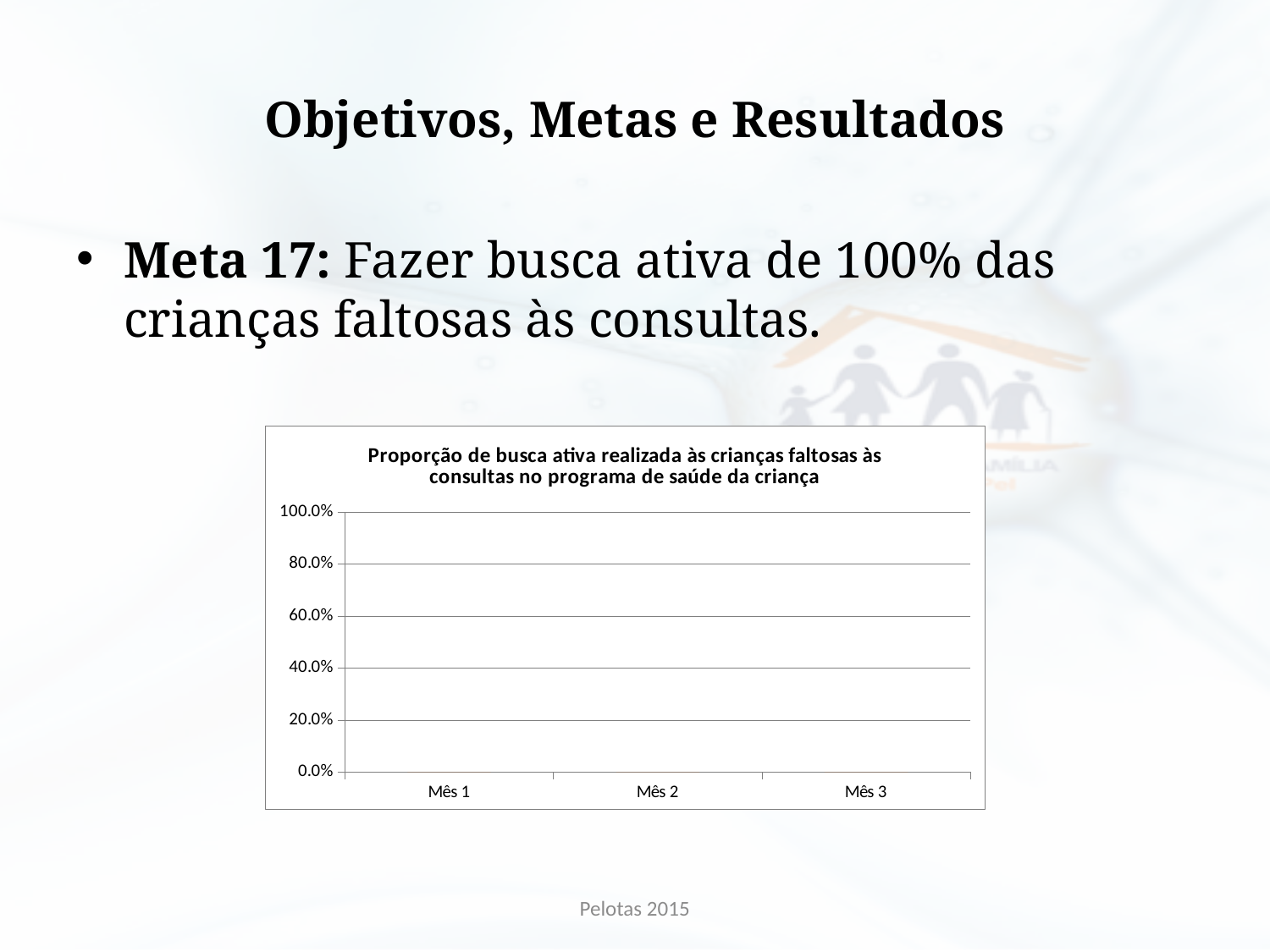
Is the value for Mês 2 greater or less than 20.0%? less What is the label of the first category on the x axis of the chart? Mês 1 What is the highest tick value shown on the y axis of the chart? 100.0% What is the label of the last category on the x axis of the chart? Mês 3 Is the value for Mês 1 greater or less than 20.0%? less What is the title of the chart? Proporção de busca ativa realizada às crianças faltosas às consultas no programa de saúde da criança Is the value for Mês 3 greater or less than 40.0%? less How many categories are shown on the x axis of the chart? 3